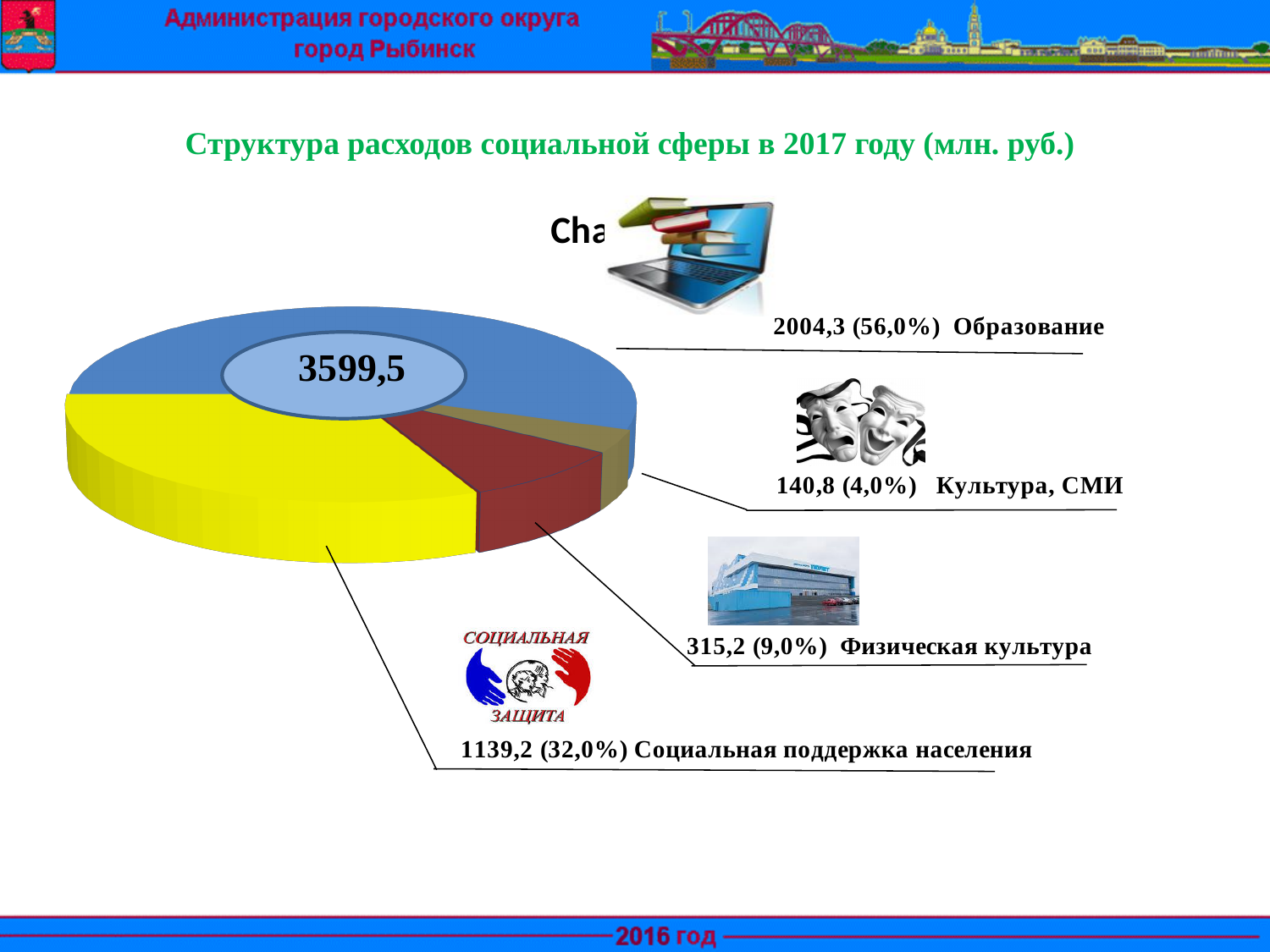
Which is larger, Физическая культура or Культура, СМИ? Физическая культура What kind of chart is shown on the slide? pie chart Which category has the smallest value? Культура, СМИ What share of the pie does Образование take? 56,0% What share of the pie does Социальная поддержка населения take? 32,0% What is the value for Культура, СМИ? 140,8 How many categories does the pie chart have? 4 What is the value for Физическая культура? 315,2 Which category has the largest value? Образование What is the value for Образование? 2004,3 What total value is shown in the centre of the pie chart? 3599,5 What is the value for Социальная поддержка населения? 1139,2